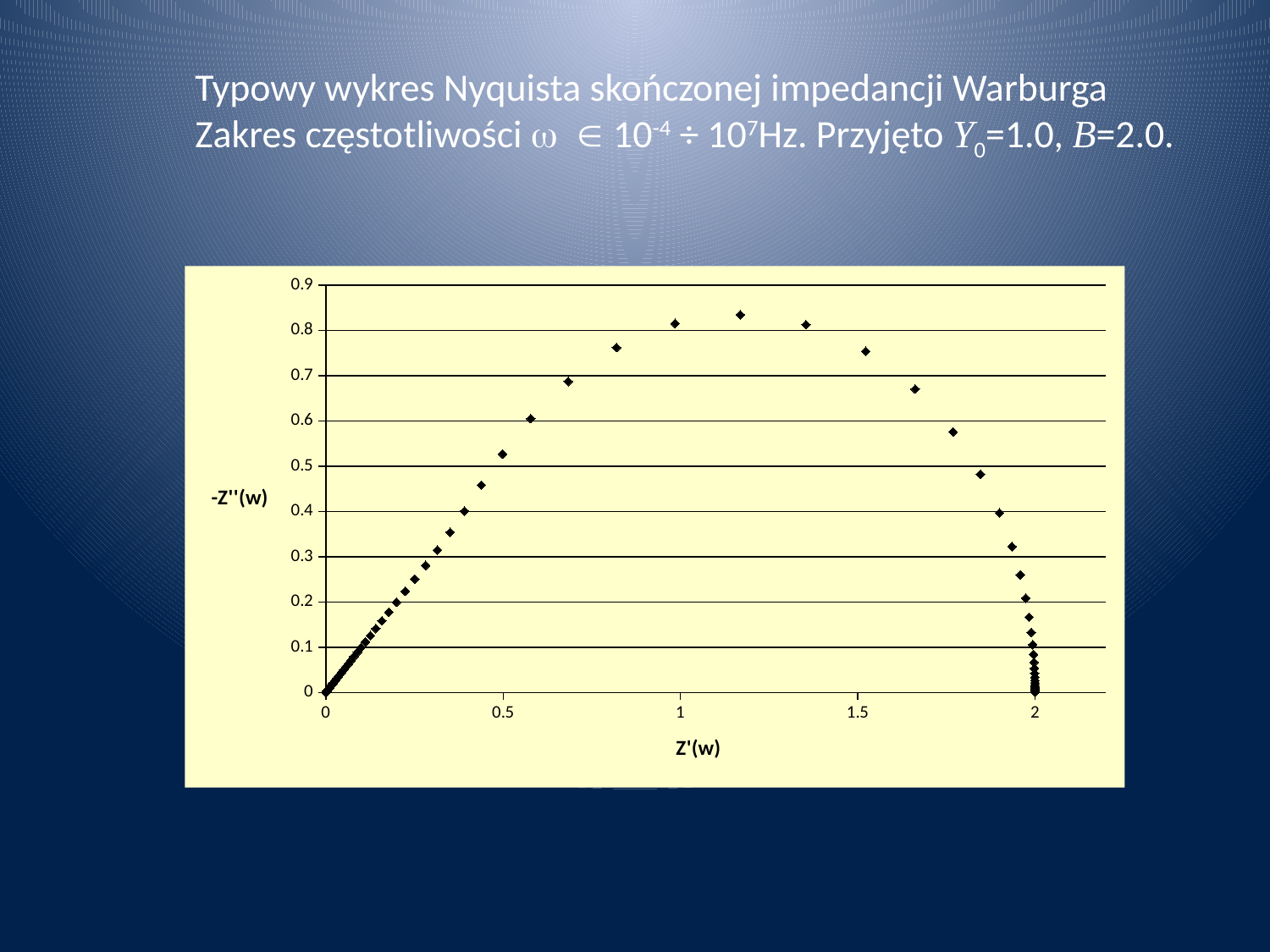
Is the highest -Z''(w) value reached by the plotted points greater or less than 0.8? greater Do the -Z''(w) values rise or fall as Z'(w) increases from 0 to 1? rise Do the -Z''(w) values rise or fall as Z'(w) increases from 1.5 to 2? fall What is the highest tick value shown on the vertical axis? 0.9 Is the largest Z'(w) value reached by the plotted points greater or less than 1.5? greater For the point plotted at Z'(w) = 0.5, is the -Z''(w) value greater or less than 0.5? greater What kind of chart is shown on the slide? scatter chart What is the label of the horizontal axis of the chart? Z'(w) What is the label of the vertical axis of the chart? -Z''(w)